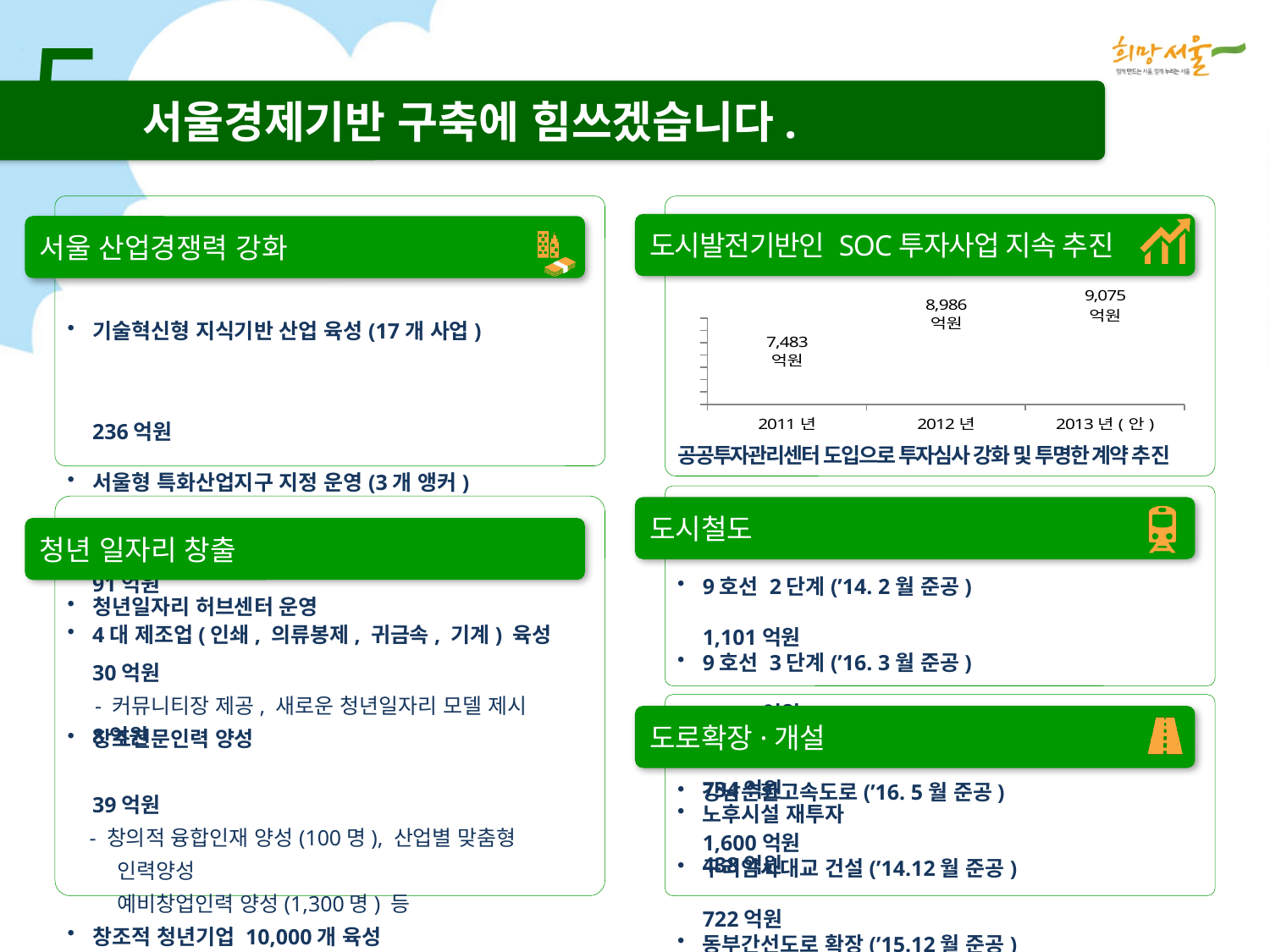
In the chart under '도시발전기반인 SOC 투자사업 지속 추진', which year has the highest value? 2013 년 (안) In the chart under '도시발전기반인 SOC 투자사업 지속 추진', what is the value for 2011 년? 7,483 억원 In the chart under '도시발전기반인 SOC 투자사업 지속 추진', which year has the lowest value? 2011 년 In the chart under '도시발전기반인 SOC 투자사업 지속 추진', what is the difference between the 2012 년 value and the 2011 년 value? 1,503 억원 What is the heading of the section that contains the chart on the slide? 도시발전기반인 SOC 투자사업 지속 추진 In the chart under '도시발전기반인 SOC 투자사업 지속 추진', what is the value for 2012 년? 8,986 억원 In the chart under '도시발전기반인 SOC 투자사업 지속 추진', do the values rise or fall from 2011 년 to 2013 년 (안)? rise In the chart under '도시발전기반인 SOC 투자사업 지속 추진', what is the difference between the 2013 년 (안) value and the 2011 년 value? 1,592 억원 How many years are shown on the x axis of the chart under '도시발전기반인 SOC 투자사업 지속 추진'? 3 In the chart under '도시발전기반인 SOC 투자사업 지속 추진', what is the value for 2013 년 (안)? 9,075 억원 In the chart under '도시발전기반인 SOC 투자사업 지속 추진', what is the difference between the 2013 년 (안) value and the 2012 년 value? 89 억원 In the chart under '도시발전기반인 SOC 투자사업 지속 추진', which is larger, the value for 2011 년 or the value for 2012 년? 2012 년